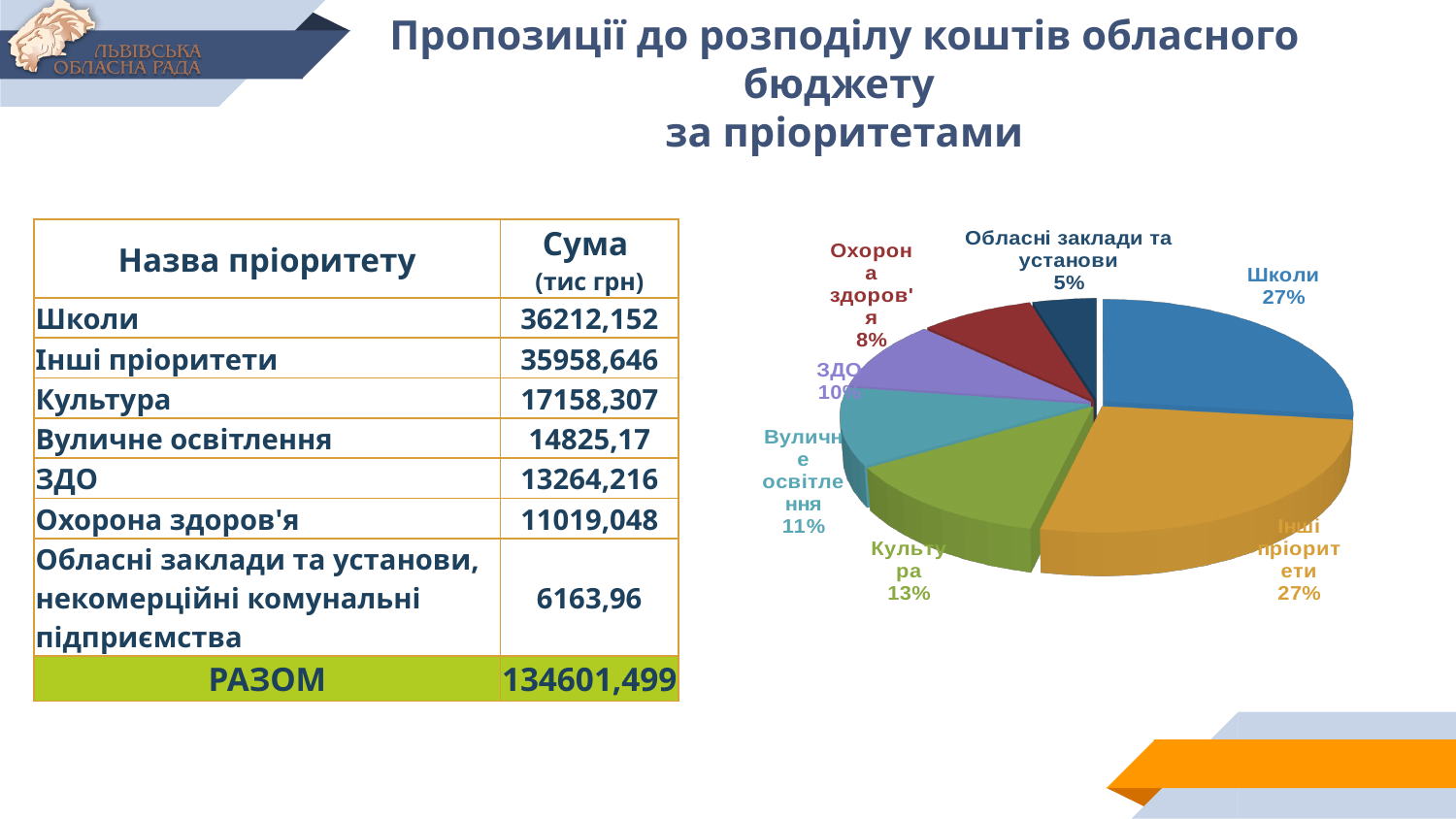
In the pie chart, which is larger: Школи or Культура? Школи How many slices does the pie chart have? 7 What share of the pie chart does Вуличне освітлення represent? 11% What share of the pie chart does Обласні заклади та установи represent? 5% What share of the pie chart does Охорона здоров'я represent? 8% What kind of chart is shown on the slide? pie chart In the pie chart, what is the difference in percentage points between Культура and Вуличне освітлення? 2 In the pie chart, which is larger: Культура or Охорона здоров'я? Культура Which slice of the pie chart is the smallest? Обласні заклади та установи What colour is the Школи slice in the pie chart? blue